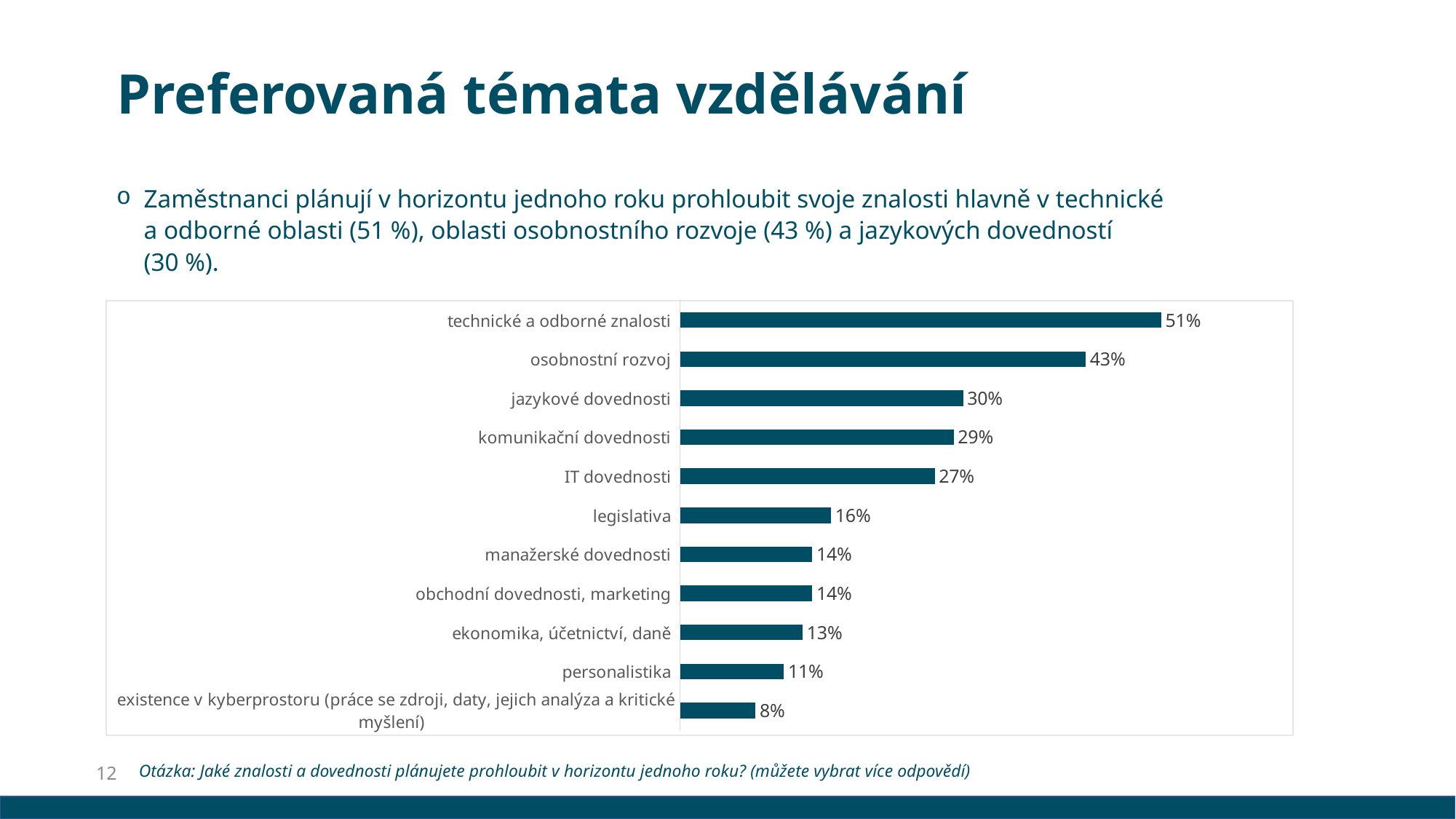
Which category has the highest value? technické a odborné znalosti What is the difference between the highest and lowest values in the chart? 43% Which two categories share the same value of 14%? manažerské dovednosti and obchodní dovednosti, marketing What is the value for 'personalistika'? 11% What is the value for 'IT dovednosti'? 27% What is the title of the slide containing the chart? Preferovaná témata vzdělávání What is the difference between the values for 'osobnostní rozvoj' and 'jazykové dovednosti'? 13% What kind of chart is shown on the slide? bar chart What is the value for 'technické a odborné znalosti'? 51% How many categories are shown in the chart? 11 Which is larger, the value for 'legislativa' or the value for 'ekonomika, účetnictví, daně'? legislativa Which category has the lowest value? existence v kyberprostoru (práce se zdroji, daty, jejich analýza a kritické myšlení)